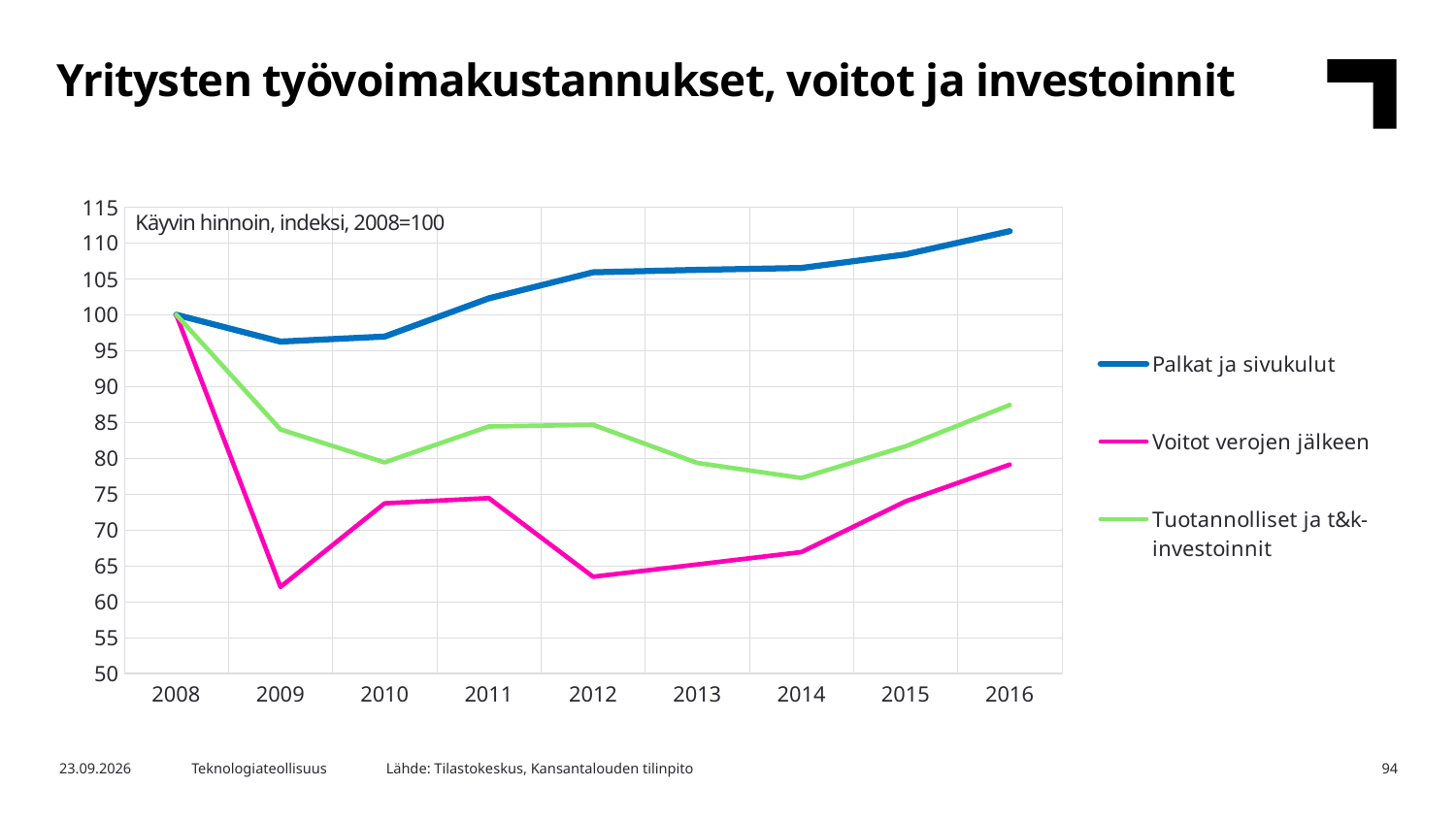
In which year is Palkat ja sivukulut at its highest? 2016 In 2016, which is larger: Palkat ja sivukulut or Voitot verojen jälkeen? Palkat ja sivukulut What is the value of all three series in 2008? 100 Is the value for Tuotannolliset ja t&k-investoinnit in 2016 greater or less than 85? greater What type of chart is shown on the slide? Line chart Is the value for Palkat ja sivukulut in 2016 greater or less than 110? greater In which year is Voitot verojen jälkeen at its lowest? 2009 How many years are shown on the x axis? 9 Is the value for Voitot verojen jälkeen in 2009 greater or less than 65? less How many series does the legend list? 3 Does Palkat ja sivukulut rise or fall from 2010 to 2016? Rise